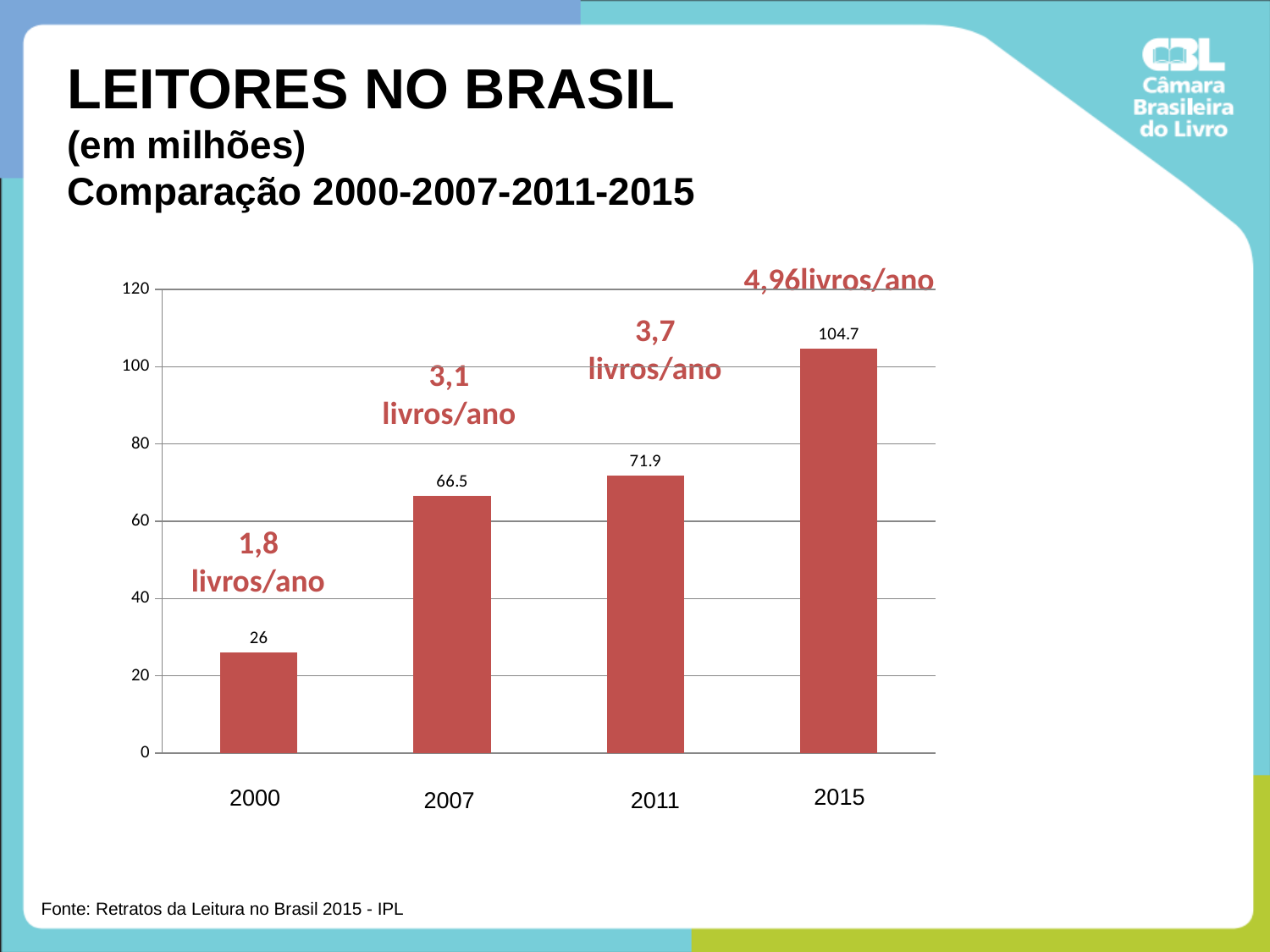
What is the difference between the values for 2015 and 2000? 78.7 What is the value for 2007? 66.5 What is the value for 2000? 26 What is the value for 2011? 71.9 What is the difference between the values for 2011 and 2007? 5.4 What is the value for 2015? 104.7 How many years are shown on the x axis? 4 What kind of chart is shown? bar chart Which is larger, the value for 2007 or the value for 2015? 2015 Which year has the highest value? 2015 Which year has the lowest value? 2000 Do the values rise or fall from 2000 to 2015? rise